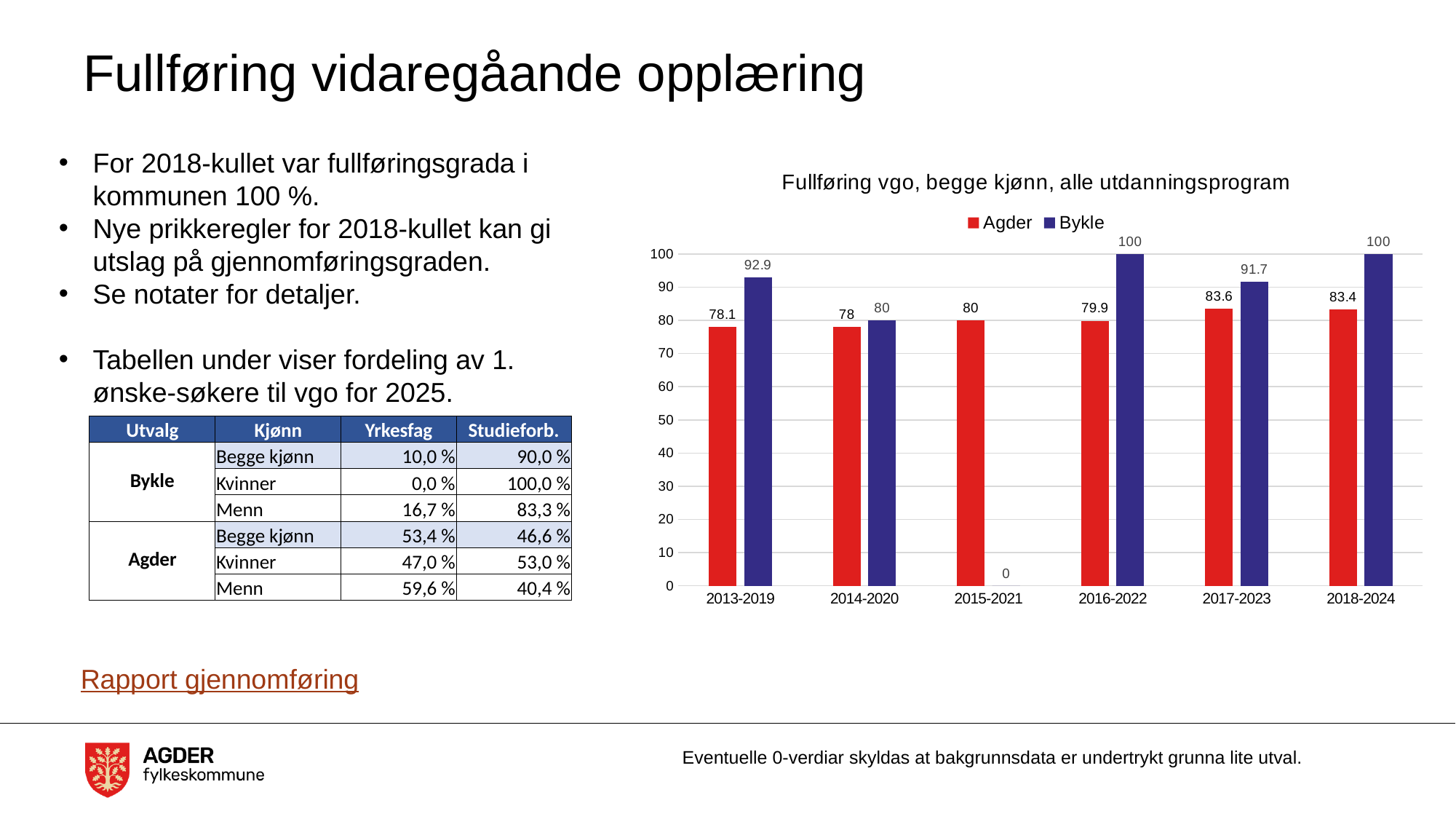
What is the value for Agder in 2013-2019? 78.1 What is the value for Agder in 2018-2024? 83.4 Which is larger in 2014-2020, Agder or Bykle? Bykle How many series does the legend list? 2 What is the value for Bykle in 2017-2023? 91.7 What is the value for Bykle in 2015-2021? 0 What type of chart is shown? Bar chart In which period is the Agder value highest? 2017-2023 How many periods are shown on the x axis? 6 What is the value for Bykle in 2013-2019? 92.9 In which period is the Bykle value lowest? 2015-2021 What is the difference between the Bykle and Agder values in 2016-2022? 20.1